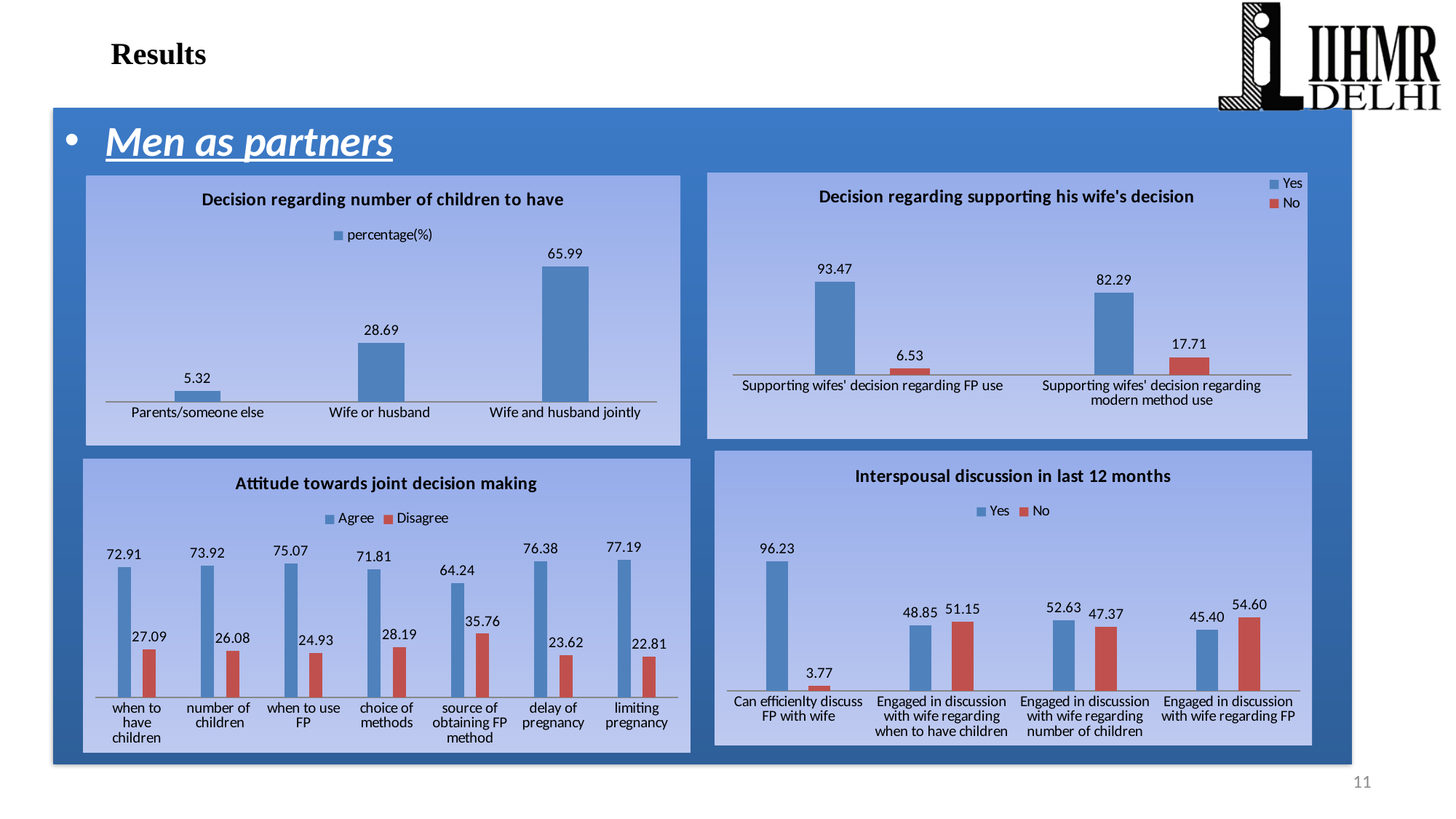
In the chart 'Decision regarding number of children to have', how many categories are shown? 3 In the chart 'Interspousal discussion in last 12 months', which is larger for 'Engaged in discussion with wife regarding FP': the 'Yes' value or the 'No' value? No In the chart 'Decision regarding number of children to have', what is the value for 'Wife and husband jointly'? 65.99 What type of chart is 'Interspousal discussion in last 12 months'? Bar chart In the chart 'Decision regarding number of children to have', which category has the lowest value? Parents/someone else In the chart 'Attitude towards joint decision making', which category has the highest 'Agree' value? limiting pregnancy In the chart 'Attitude towards joint decision making', how many categories are shown on the x axis? 7 In the chart 'Interspousal discussion in last 12 months', what is the 'Yes' value for 'Can efficienlty discuss FP with wife'? 96.23 In the chart 'Decision regarding supporting his wife's decision', what is the difference between the 'Yes' values for FP use and modern method use? 11.18 In the chart 'Decision regarding supporting his wife's decision', what is the 'No' value for 'Supporting wifes' decision regarding modern method use'? 17.71 In the chart 'Attitude towards joint decision making', how many series does the legend list? 2 In the chart 'Attitude towards joint decision making', what is the 'Disagree' value for 'source of obtaining FP method'? 35.76